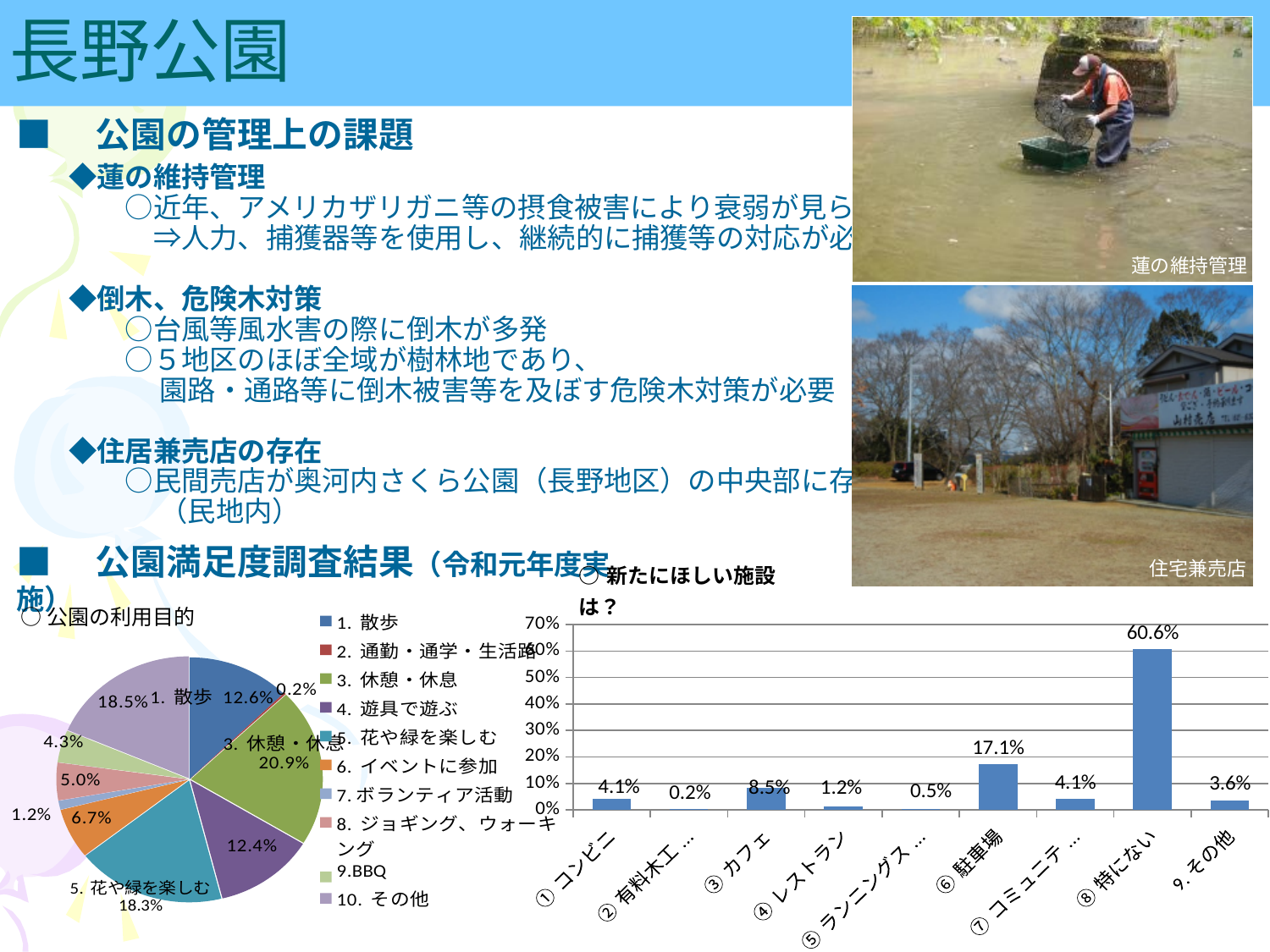
In the pie chart titled 公園の利用目的, what is the share for 5. 花や緑を楽しむ? 18.3% In the bar chart titled 新たにほしい施設は？, which category has the lowest value? ② 有料木工… In the bar chart titled 新たにほしい施設は？, which category has the highest value? ⑧ 特にない In the bar chart titled 新たにほしい施設は？, what is the value for ③ カフェ? 8.5% In the bar chart titled 新たにほしい施設は？, what is the difference between ⑧ 特にない and ⑥ 駐車場? 43.5% In the bar chart titled 新たにほしい施設は？, what is the value for ⑥ 駐車場? 17.1% In the bar chart titled 新たにほしい施設は？, what is the value for ⑧ 特にない? 60.6% How many categories are shown in the bar chart titled 新たにほしい施設は？? 9 How many entries does the legend of the pie chart titled 公園の利用目的 list? 10 In the pie chart titled 公園の利用目的, what is the share for 3. 休憩・休息? 20.9% What kind of chart is the chart titled 新たにほしい施設は？? bar chart In the bar chart titled 新たにほしい施設は？, which is larger, ③ カフェ or ④ レストラン? ③ カフェ